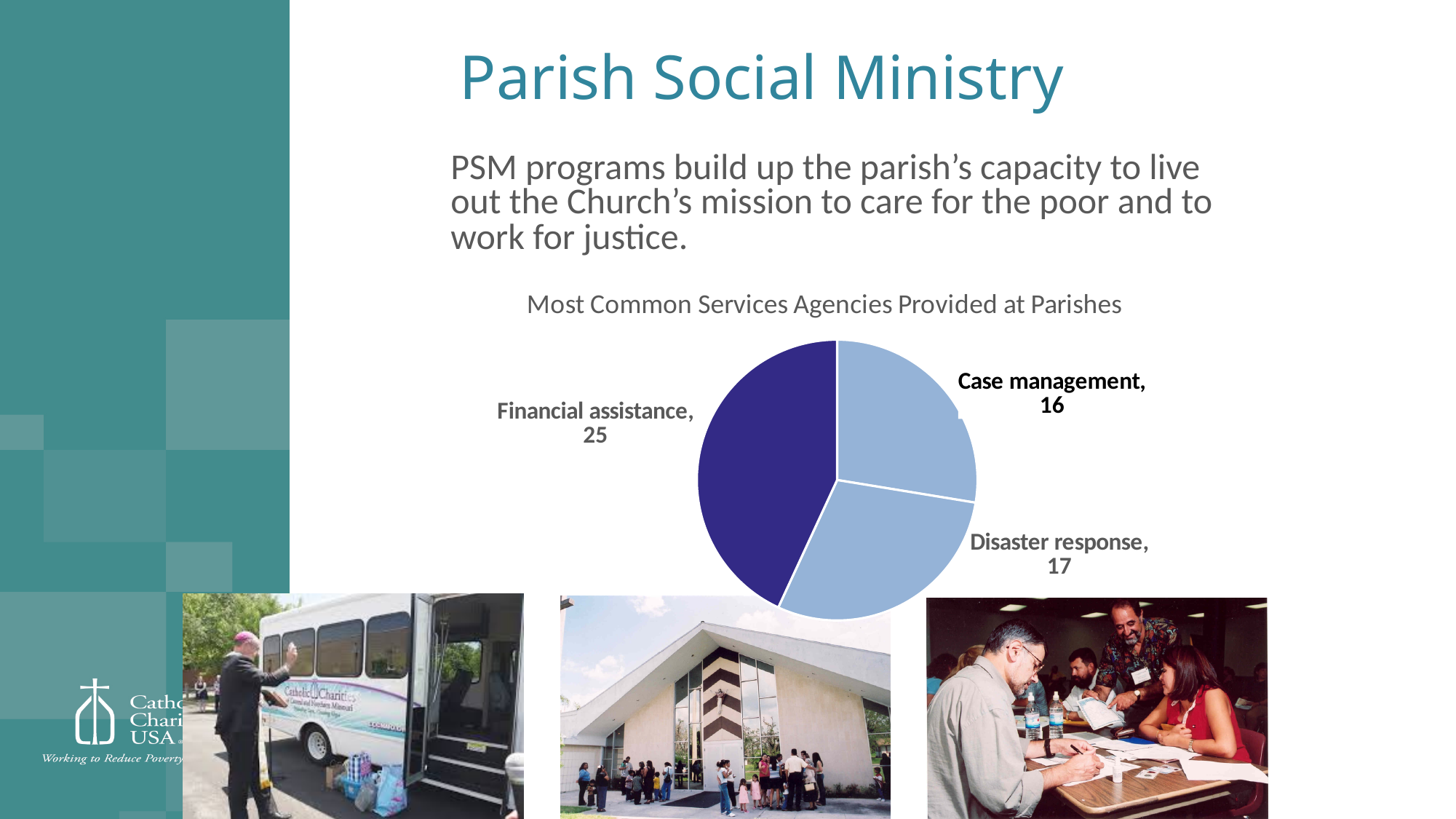
How many categories are shown in the pie chart? 3 What is the total of all the slices in the pie chart? 58 Which is larger, the value for Financial assistance or the value for Case management? Financial assistance What is the value for Financial assistance? 25 What is the value for Case management? 16 Which category has the smallest slice of the pie? Case management What is the difference between the values for Financial assistance and Disaster response? 8 Which category has the largest slice of the pie? Financial assistance What is the title of the chart? Most Common Services Agencies Provided at Parishes What is the value for Disaster response? 17 What type of chart is shown on the slide? pie chart What is the difference between the values for Disaster response and Case management? 1